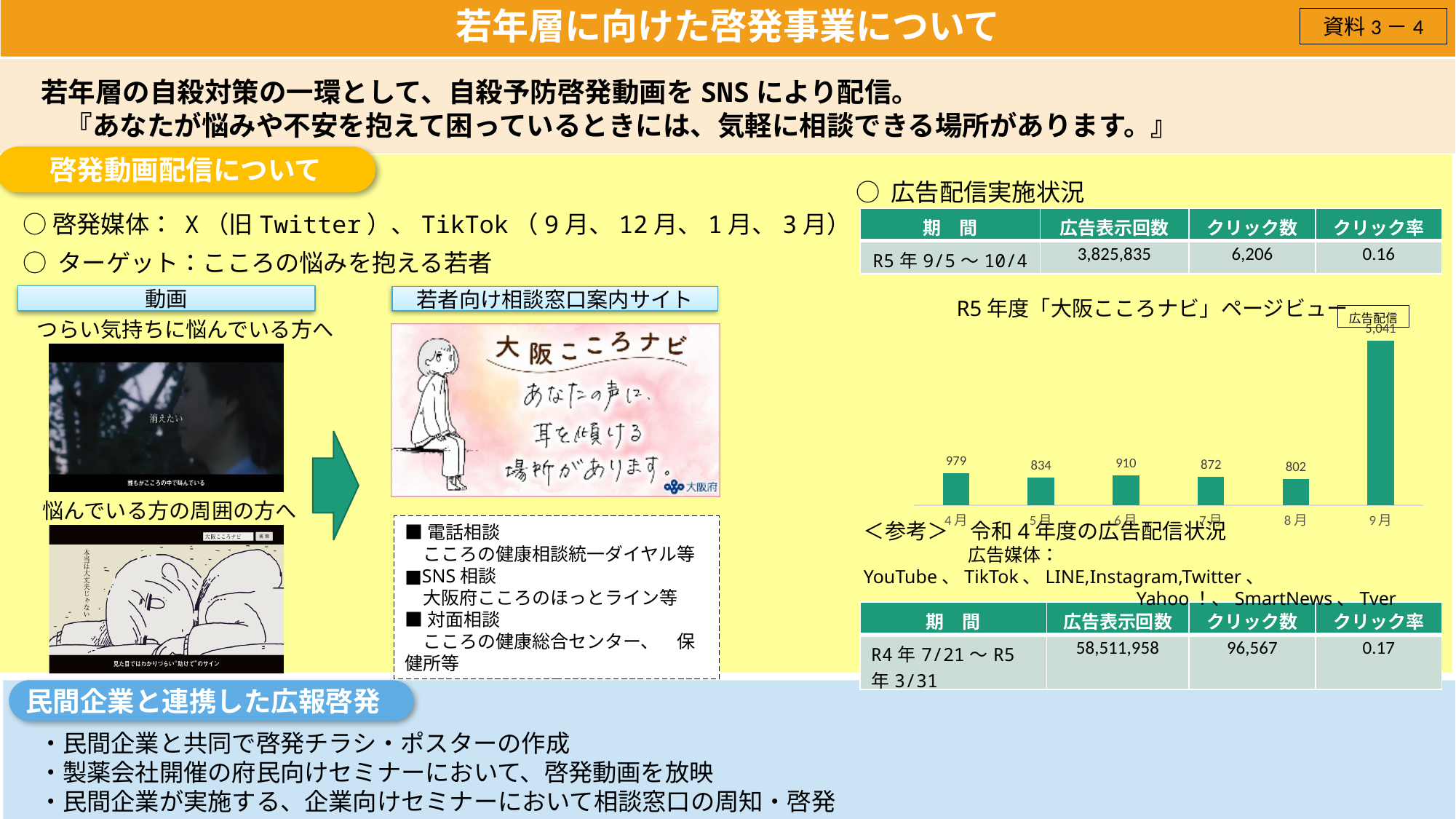
In the R5年度「大阪こころナビ」ページビュー chart, which is larger, the value for 6月 or the value for 7月? 6月 In the R5年度「大阪こころナビ」ページビュー chart, what is the value for 9月? 5,041 In the R5年度「大阪こころナビ」ページビュー chart, what is the value for 6月? 910 In the R5年度「大阪こころナビ」ページビュー chart, what is the value for 8月? 802 How many months are plotted in the R5年度「大阪こころナビ」ページビュー chart? 6 In the R5年度「大阪こころナビ」ページビュー chart, what is the difference between the values for 4月 and 5月? 145 In the R5年度「大阪こころナビ」ページビュー chart, which month has the lowest value? 8月 In the R5年度「大阪こころナビ」ページビュー chart, what is the difference between the values for 9月 and 8月? 4,239 In the R5年度「大阪こころナビ」ページビュー chart, what is the value for 4月? 979 What annotation label is placed next to the 9月 bar in the R5年度「大阪こころナビ」ページビュー chart? 広告配信 What type of chart is used to show the R5年度「大阪こころナビ」ページビュー data? bar chart In the R5年度「大阪こころナビ」ページビュー chart, which month has the highest value? 9月